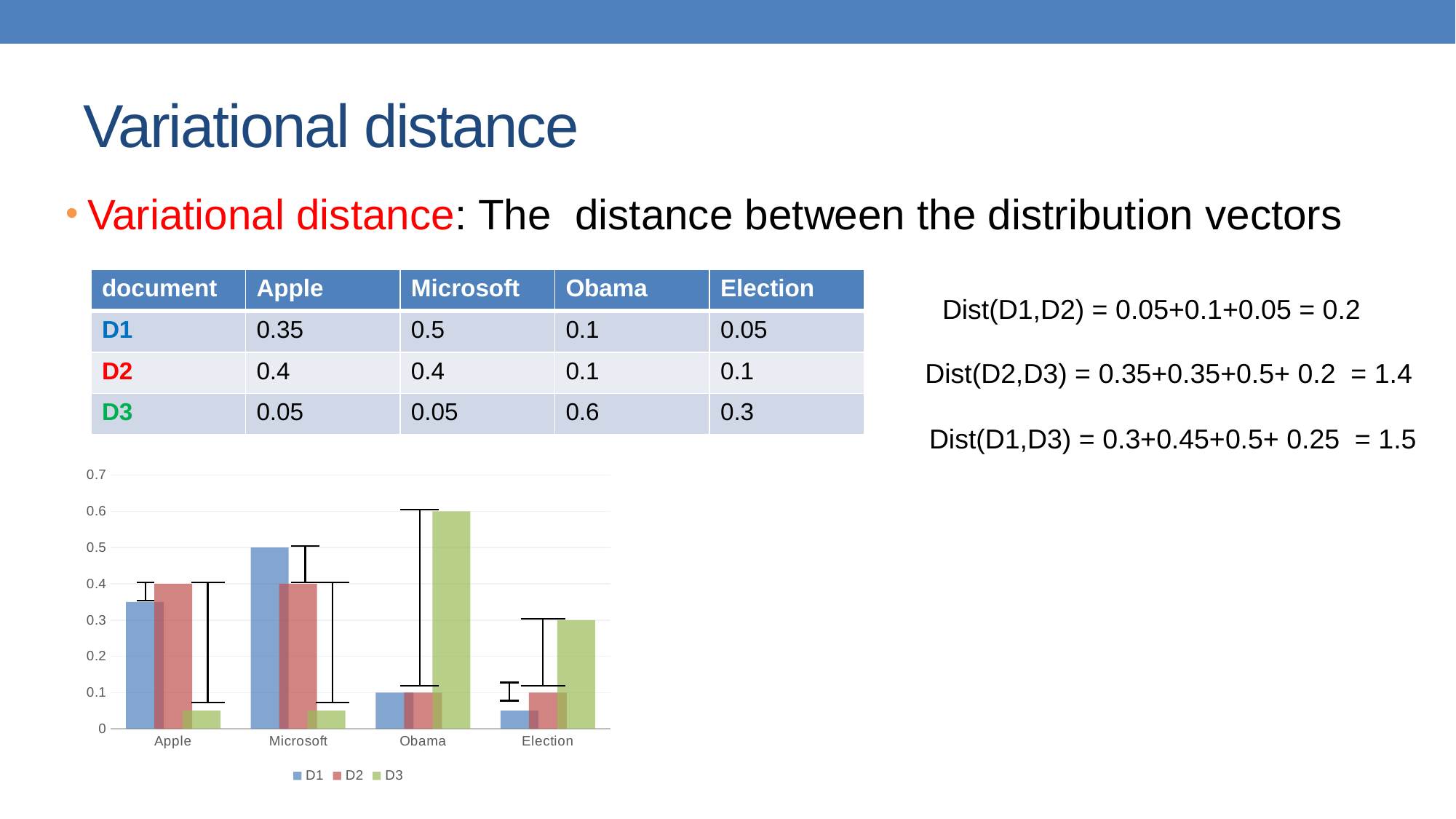
Which category has the lowest D1 value in the chart? Election In the chart, is the D3 value for Microsoft greater or less than 0.1? less Which category has the highest D3 value in the chart? Obama In the chart, is the D1 value for Apple greater or less than 0.3? greater What is the value of D1 for Microsoft in the chart? 0.5 How many categories are shown on the x axis of the chart? 4 In the chart, which is larger for Obama: D1 or D3? D3 What is the value of D3 for Election in the chart? 0.3 What is the value of D3 for Obama in the chart? 0.6 What kind of chart is shown on the slide? bar chart How many series does the chart legend list? 3 What is the difference between the D1 and D3 values for Microsoft in the chart? 0.45